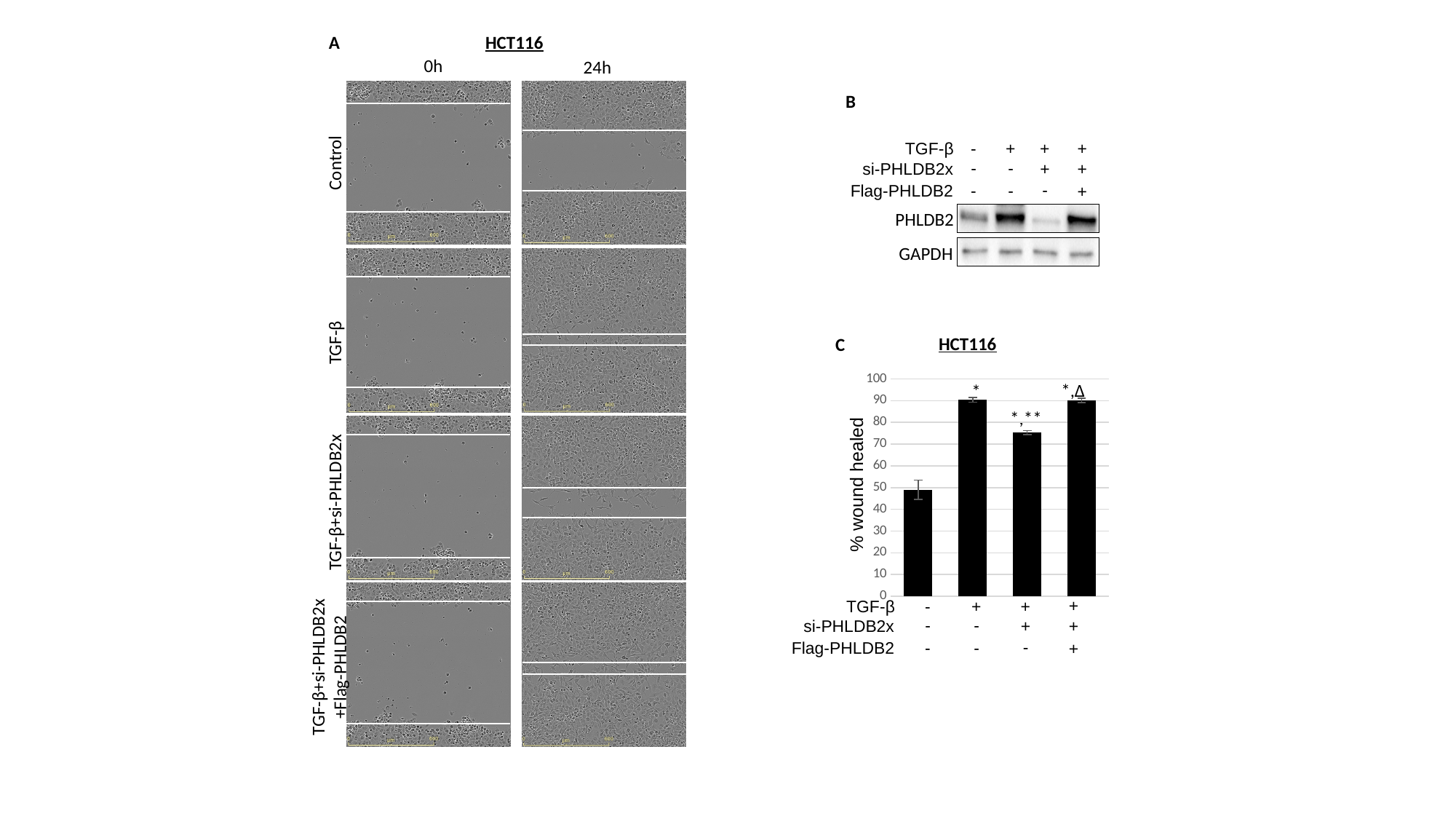
In the panel C chart, which condition has the lowest % wound healed? TGF-β −, si-PHLDB2x −, Flag-PHLDB2 − (control) In the panel C chart, is the % wound healed for the TGF-β only condition (TGF-β +, si-PHLDB2x −, Flag-PHLDB2 −) greater or less than 80? greater In the panel C chart, is the % wound healed for the TGF-β + si-PHLDB2x + Flag-PHLDB2 condition greater or less than 80? greater In the panel C chart, is the % wound healed for the TGF-β + si-PHLDB2x condition (Flag-PHLDB2 −) greater or less than 80? less In the panel C chart, which has the higher % wound healed: the TGF-β only condition or the TGF-β + si-PHLDB2x condition (Flag-PHLDB2 −)? TGF-β only What is the y-axis label of the panel C chart? % wound healed What is the title of the panel C chart? HCT116 What kind of chart is panel C on the slide? bar chart In the panel C chart, which has the higher % wound healed: the control condition (all −) or the TGF-β only condition? TGF-β only How many bars are plotted in the panel C chart? 4